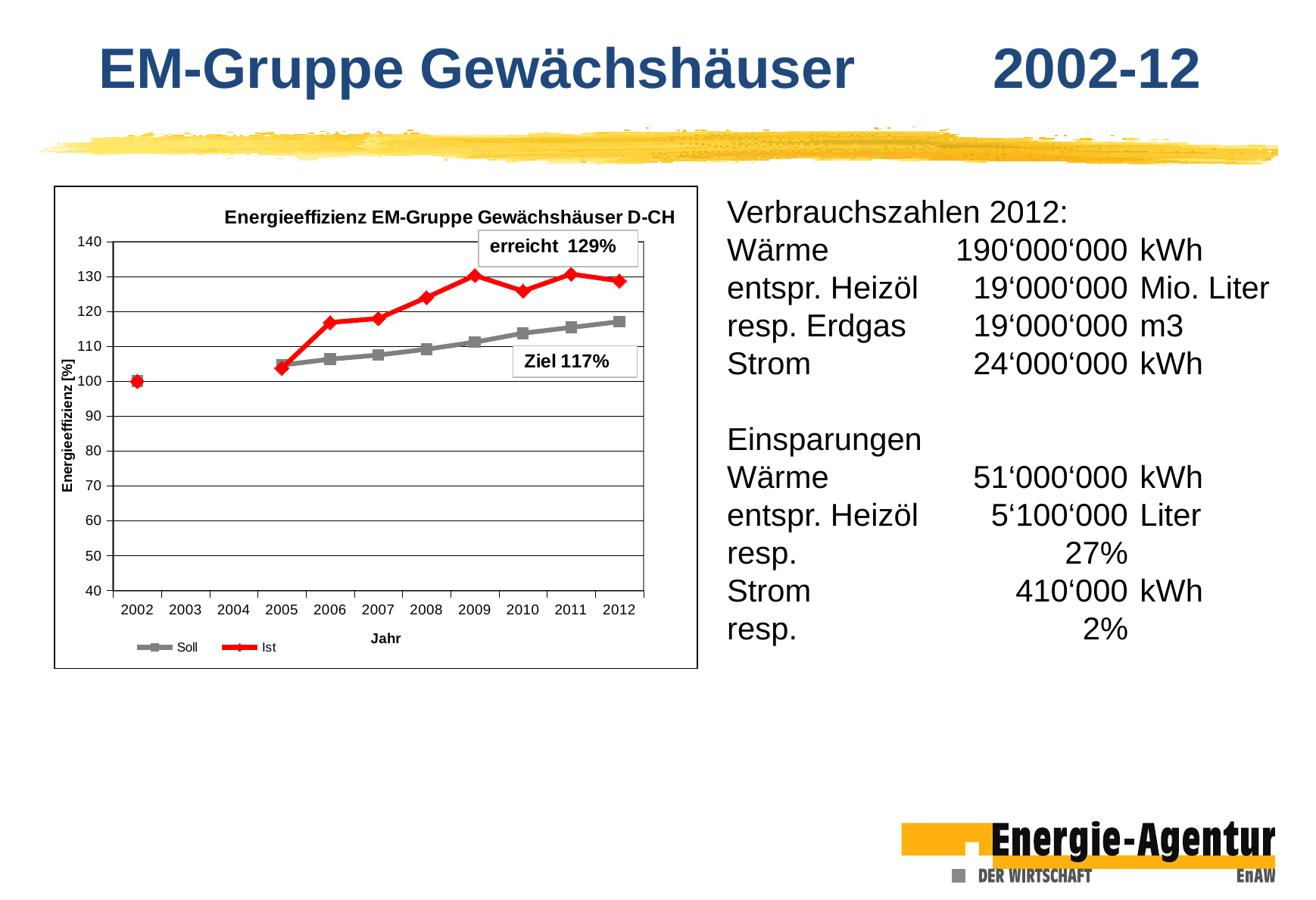
Does the Soll series rise or fall from 2005 to 2012? rise What are the two series named in the chart legend? Soll and Ist Is the Soll value for 2006 greater or less than 110? less How many series does the chart legend list? 2 What value did the Ist series reach in 2012, according to the annotation on the chart? 129% By how many percentage points does the achieved value (erreicht) exceed the target (Ziel) in 2012? 12 What is the Ziel (target) value shown on the chart for 2012? 117% What is the value of both series in 2002? 100 In 2012, which series has the higher value, Soll or Ist? Ist What is the title of the chart? Energieeffizienz EM-Gruppe Gewächshäuser D-CH Is the Ist value for 2009 greater or less than 120? greater What kind of chart is shown on the slide? line chart